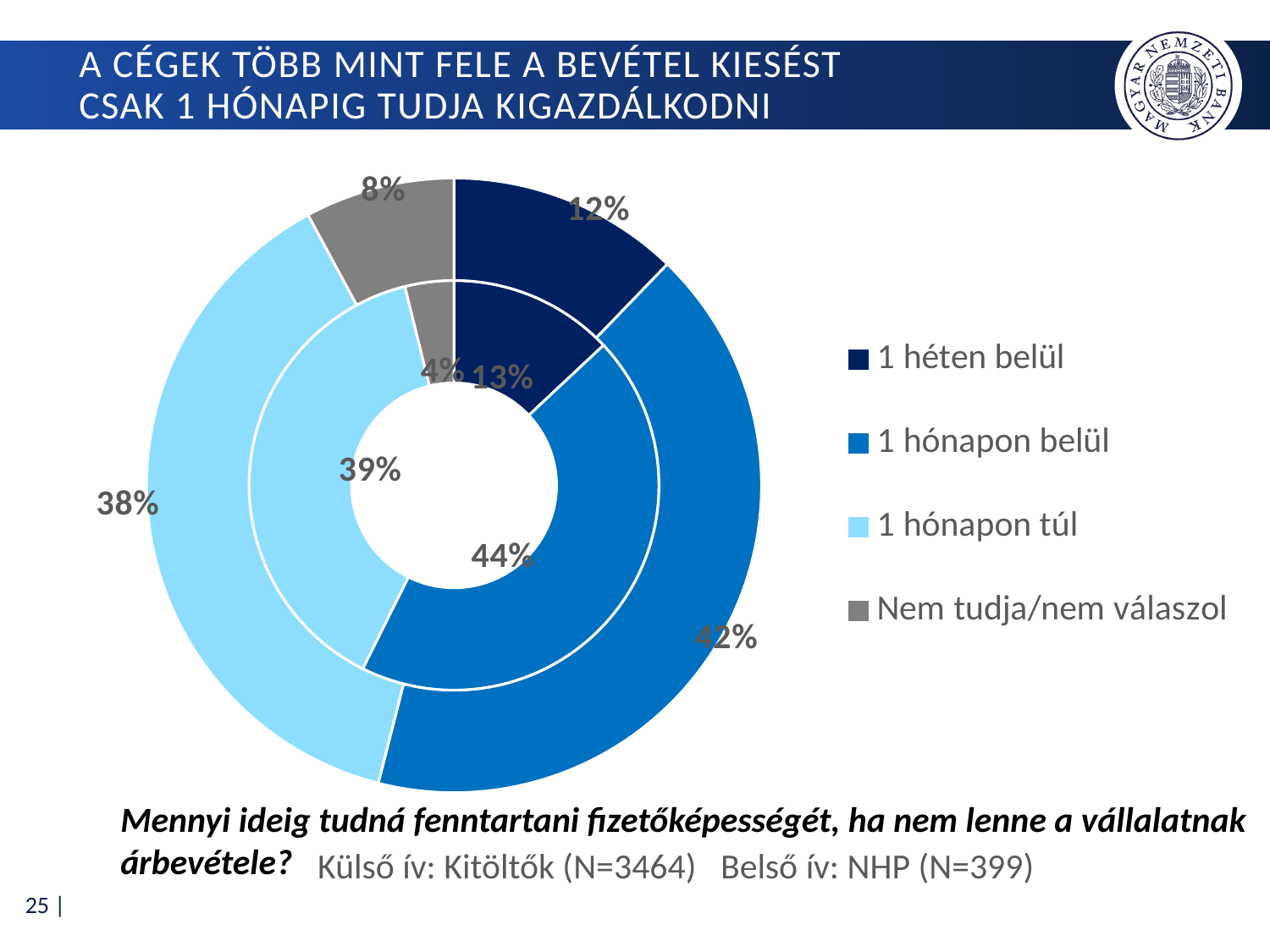
How many categories does the legend list? 4 Which category has the smallest share in the inner ring (NHP, N=399)? Nem tudja/nem válaszol What is the difference between the '1 hónapon belül' share and the '1 hónapon túl' share in the inner ring (NHP, N=399)? 5 percentage points In the outer ring (Kitöltők, N=3464), what share of firms answered '1 hónapon belül'? 42% In the outer ring (Kitöltők, N=3464), what share of firms answered '1 héten belül'? 12% Which ring has the larger share for 'Nem tudja/nem válaszol', the outer ring (Kitöltők) or the inner ring (NHP)? outer ring (Kitöltők) In the outer ring (Kitöltők, N=3464), what share of firms answered 'Nem tudja/nem válaszol'? 8% Which category has the largest share in the outer ring (Kitöltők, N=3464)? 1 hónapon belül In the outer ring (Kitöltők, N=3464), what share of firms answered '1 hónapon túl'? 38% What kind of chart is shown on the slide? doughnut chart In the inner ring (NHP, N=399), what share of firms answered '1 hónapon belül'? 44% In the inner ring (NHP, N=399), what share of firms answered 'Nem tudja/nem válaszol'? 4%